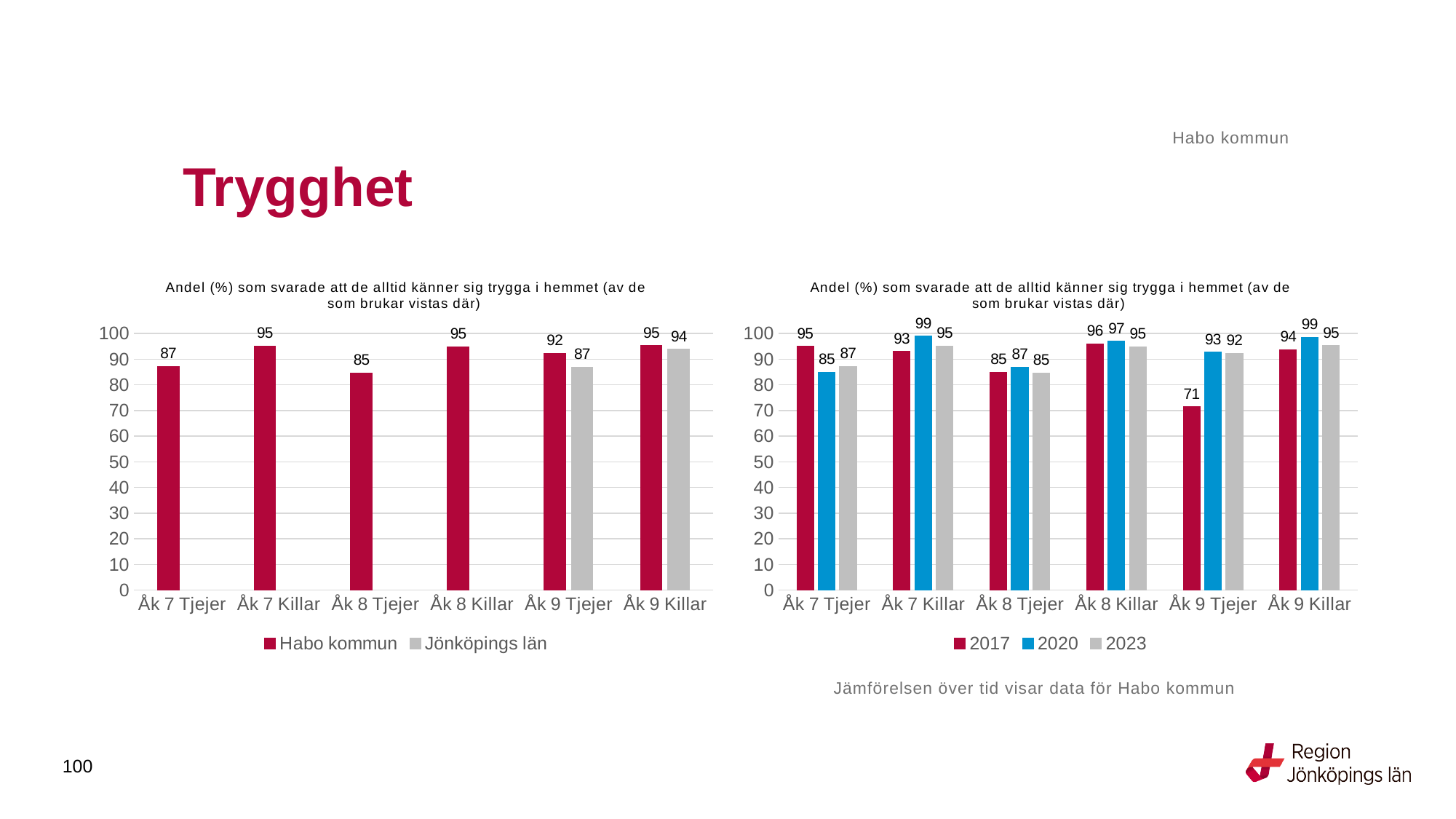
What type of chart is the right chart? Bar chart In the left chart, what is the value for Habo kommun for Åk 7 Tjejer? 87 In the right chart, which category has the lowest value for 2017? Åk 9 Tjejer In the right chart, what is the difference between the 2020 and 2017 values for Åk 9 Tjejer? 22 In the right chart, which is larger for Åk 7 Tjejer: the 2017 value or the 2020 value? 2017 In the left chart, what is the difference between Habo kommun and Jönköpings län for Åk 9 Tjejer? 5 In the left chart, what is the value for Jönköpings län for Åk 9 Killar? 94 In the right chart, what is the value for 2017 for Åk 9 Tjejer? 71 In the left chart, how many series does the legend list? 2 In the left chart, which category has the lowest value for Habo kommun? Åk 8 Tjejer In the right chart, how many categories are shown on the x axis? 6 In the right chart, what is the value for 2020 for Åk 8 Tjejer? 87